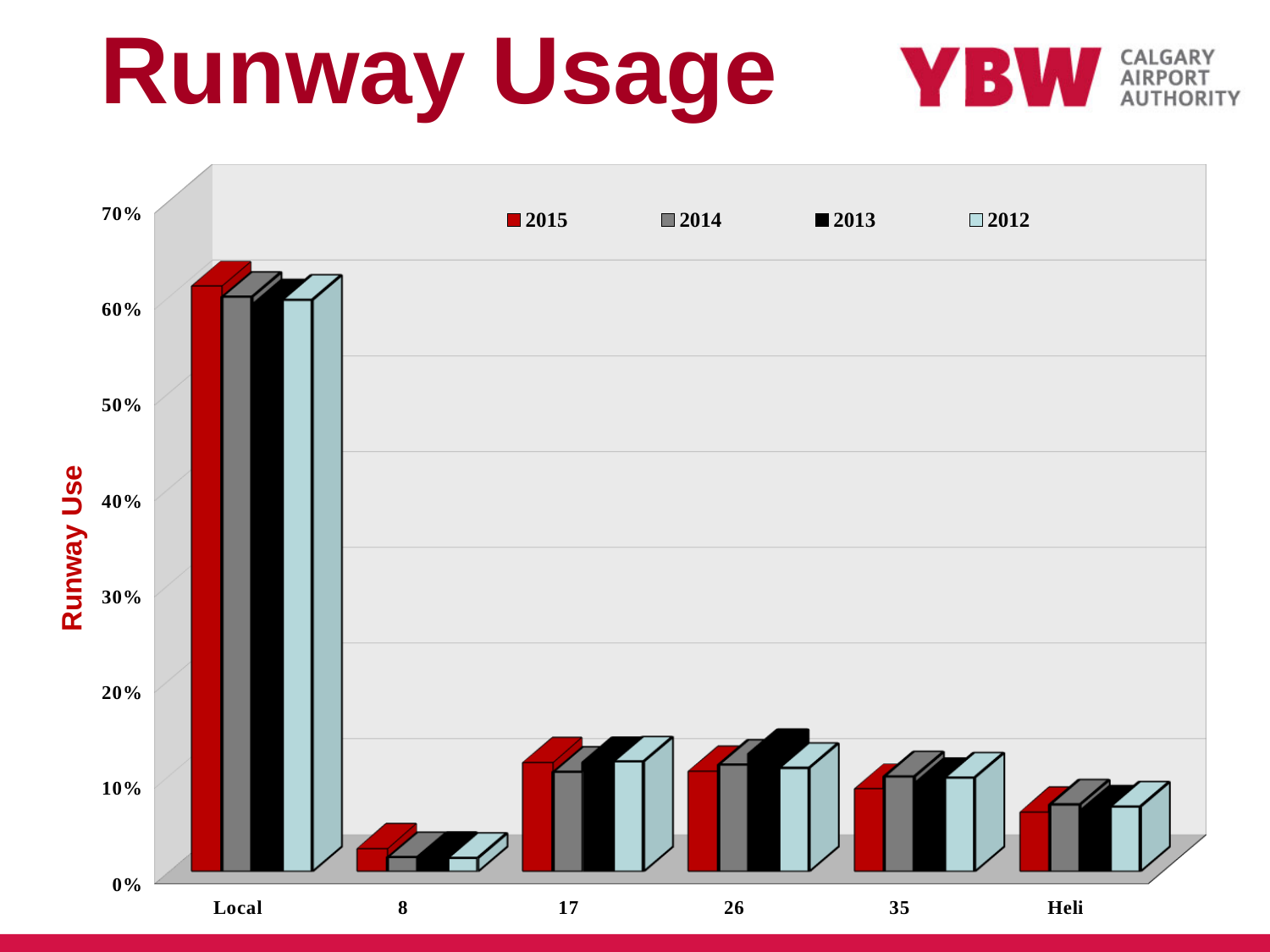
How many runway categories are shown on the x axis? 6 How many series does the legend list? 4 Which year is shown in red in the legend? 2015 Which category has the lowest runway use for 2015? 8 For 2012, which has the larger runway use: Local or runway 17? Local What kind of chart is shown on the slide? Bar chart Is the 2013 value for runway 26 greater or less than 10%? greater Which category has the highest runway use for 2015? Local Is the 2015 value for Local greater or less than 50%? greater Is the 2015 value for runway 8 greater or less than 10%? less What is the title of the y axis? Runway Use